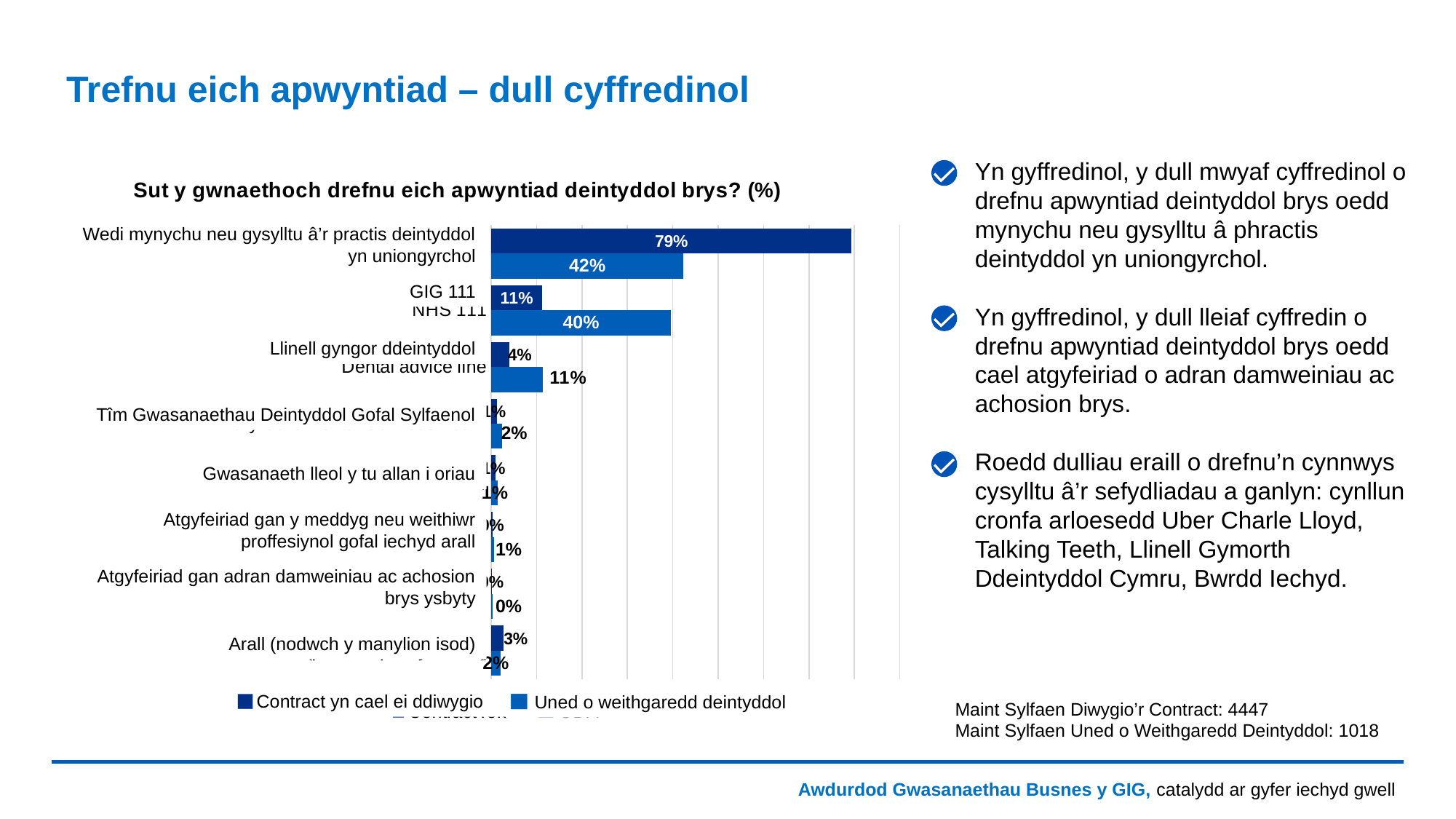
What is the value for 'GIG 111' in the 'Contract yn cael ei ddiwygio' series? 11% What is the value for 'Wedi mynychu neu gysylltu â'r practis deintyddol yn uniongyrchol' in the 'Uned o weithgaredd deintyddol' series? 42% What is the value for 'Llinell gyngor ddeintyddol' in the 'Uned o weithgaredd deintyddol' series? 11% What is the title of the chart? Sut y gwnaethoch drefnu eich apwyntiad deintyddol brys? (%) How many categories are shown on the chart? 8 What is the value for 'GIG 111' in the 'Uned o weithgaredd deintyddol' series? 40% How many series does the chart legend list? 2 For 'GIG 111', which series has the larger value: 'Contract yn cael ei ddiwygio' or 'Uned o weithgaredd deintyddol'? Uned o weithgaredd deintyddol Which category has the highest value in the 'Contract yn cael ei ddiwygio' series? Wedi mynychu neu gysylltu â'r practis deintyddol yn uniongyrchol What is the value for 'Wedi mynychu neu gysylltu â'r practis deintyddol yn uniongyrchol' in the 'Contract yn cael ei ddiwygio' series? 79% What type of chart is shown on the slide? bar chart What is the difference between the 'Contract yn cael ei ddiwygio' and 'Uned o weithgaredd deintyddol' values for 'Wedi mynychu neu gysylltu â'r practis deintyddol yn uniongyrchol'? 37%